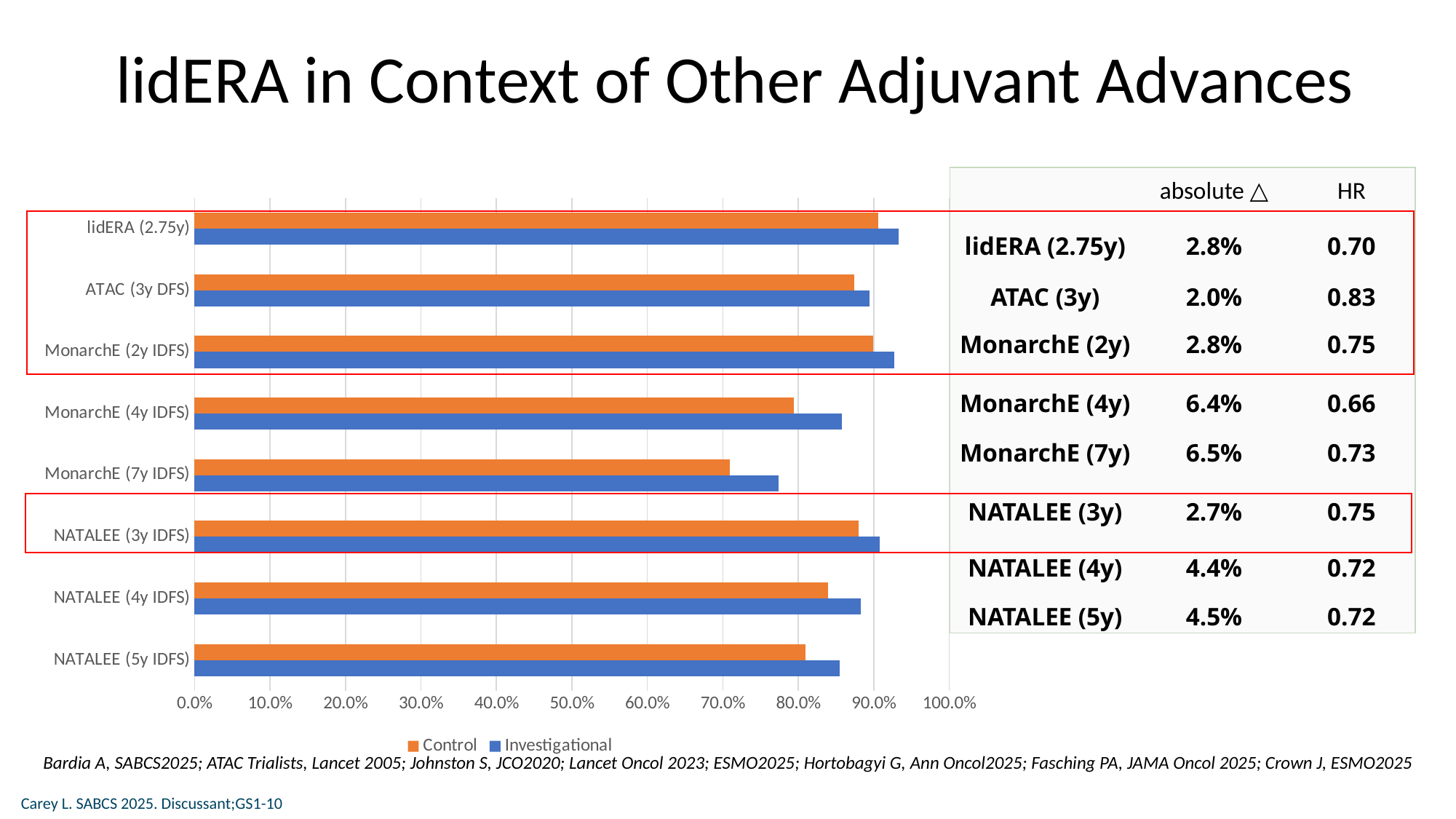
Which category has the lowest Control value? MonarchE (7y IDFS) Which is larger: the Control value for NATALEE (5y IDFS) or the Control value for MonarchE (7y IDFS)? NATALEE (5y IDFS) Is the Control value for MonarchE (7y IDFS) greater or less than 80.0%? less Which category has the lowest Investigational value? MonarchE (7y IDFS) Is the Investigational value for lidERA (2.75y) greater or less than 90.0%? greater What is the title of the slide containing the chart? lidERA in Context of Other Adjuvant Advances How many series does the chart legend list? 2 For MonarchE (7y IDFS), which is larger: the Control value or the Investigational value? Investigational What kind of chart is shown on the slide? bar chart Is the Investigational value for MonarchE (4y IDFS) greater or less than 90.0%? less Which colour represents the Control series in the chart? orange How many trial categories are plotted on the chart? 8